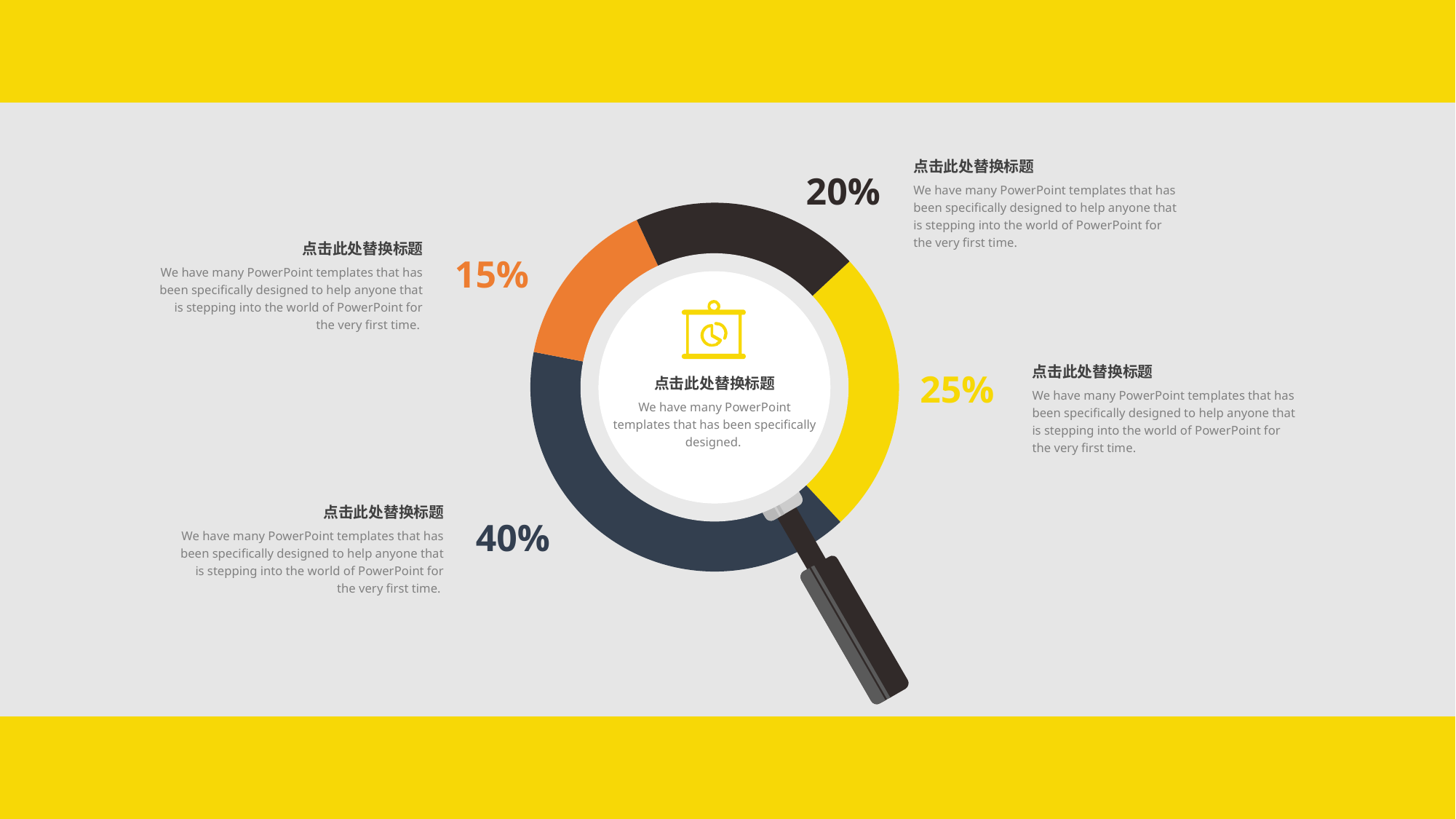
What is the difference between the dark blue segment's value and the yellow segment's value? 15% Which segment of the donut chart has the smallest share? The orange segment (15%) What percentage is shown for the orange segment of the donut chart? 15% Which is larger, the black segment's value or the orange segment's value? The black segment (20%) What percentage is shown for the black segment of the donut chart? 20% Which segment of the donut chart has the largest share? The dark blue segment (40%) How many segments does the donut chart have? 4 What percentage is shown for the yellow segment of the donut chart? 25% What kind of chart is shown on the slide? Donut (pie) chart What percentage is shown for the dark blue segment of the donut chart? 40% What colour is the segment labelled 25%? Yellow What do the four percentages on the donut chart add up to? 100%